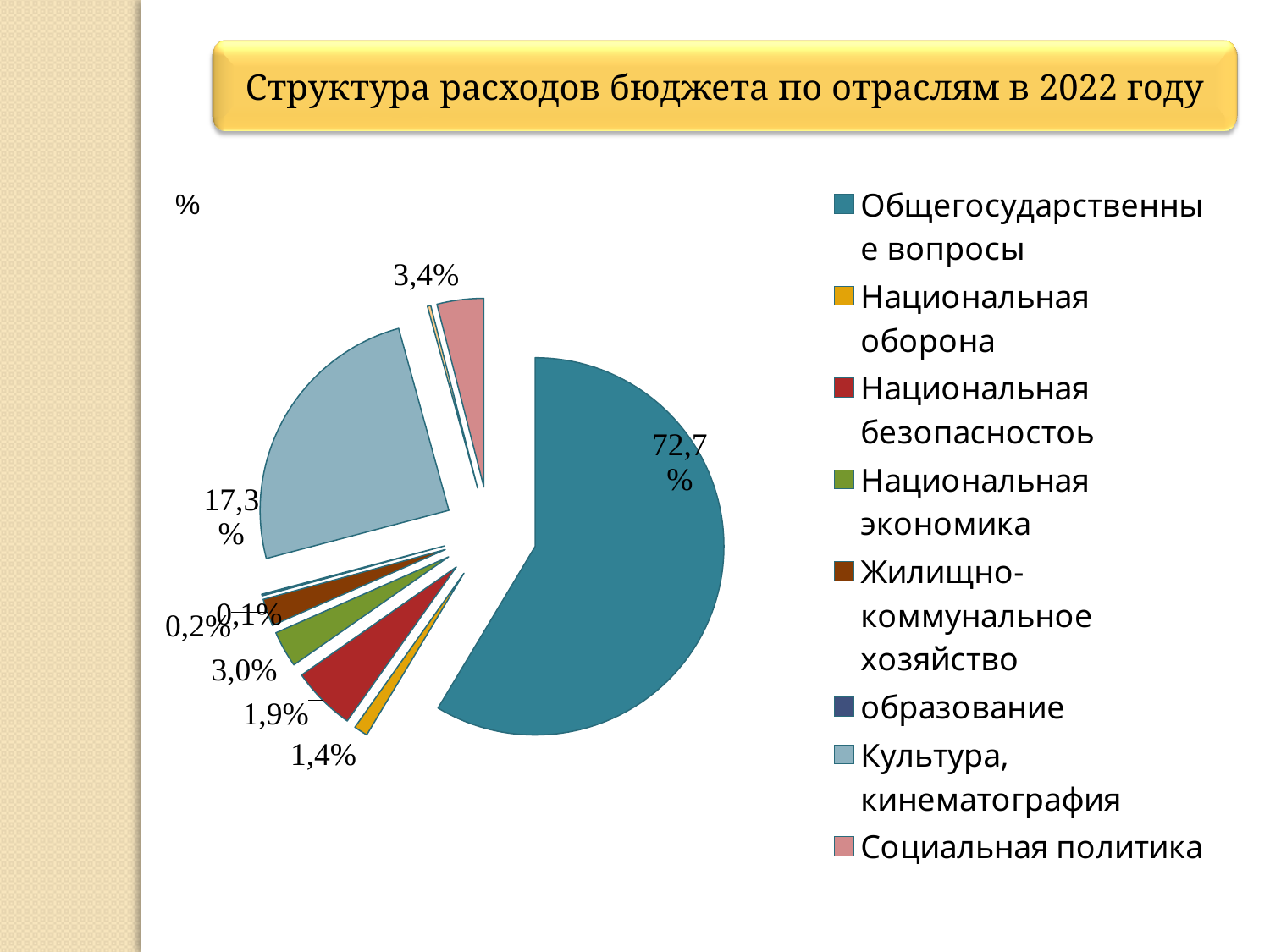
What share of the pie is Национальная экономика? 3,0% What share of the pie is Национальная оборона? 1,4% Which is larger, the share of Национальная безопасность or the share of Национальная оборона? Национальная безопасность What is the difference between the shares of Общегосударственные вопросы and Культура, кинематография? 55,4% What is the title of the chart? Структура расходов бюджета по отраслям в 2022 году How many entries does the legend list? 8 What share of the pie is Общегосударственные вопросы? 72,7% What kind of chart is shown on the slide? pie chart Which category has the largest share of the pie? Общегосударственные вопросы